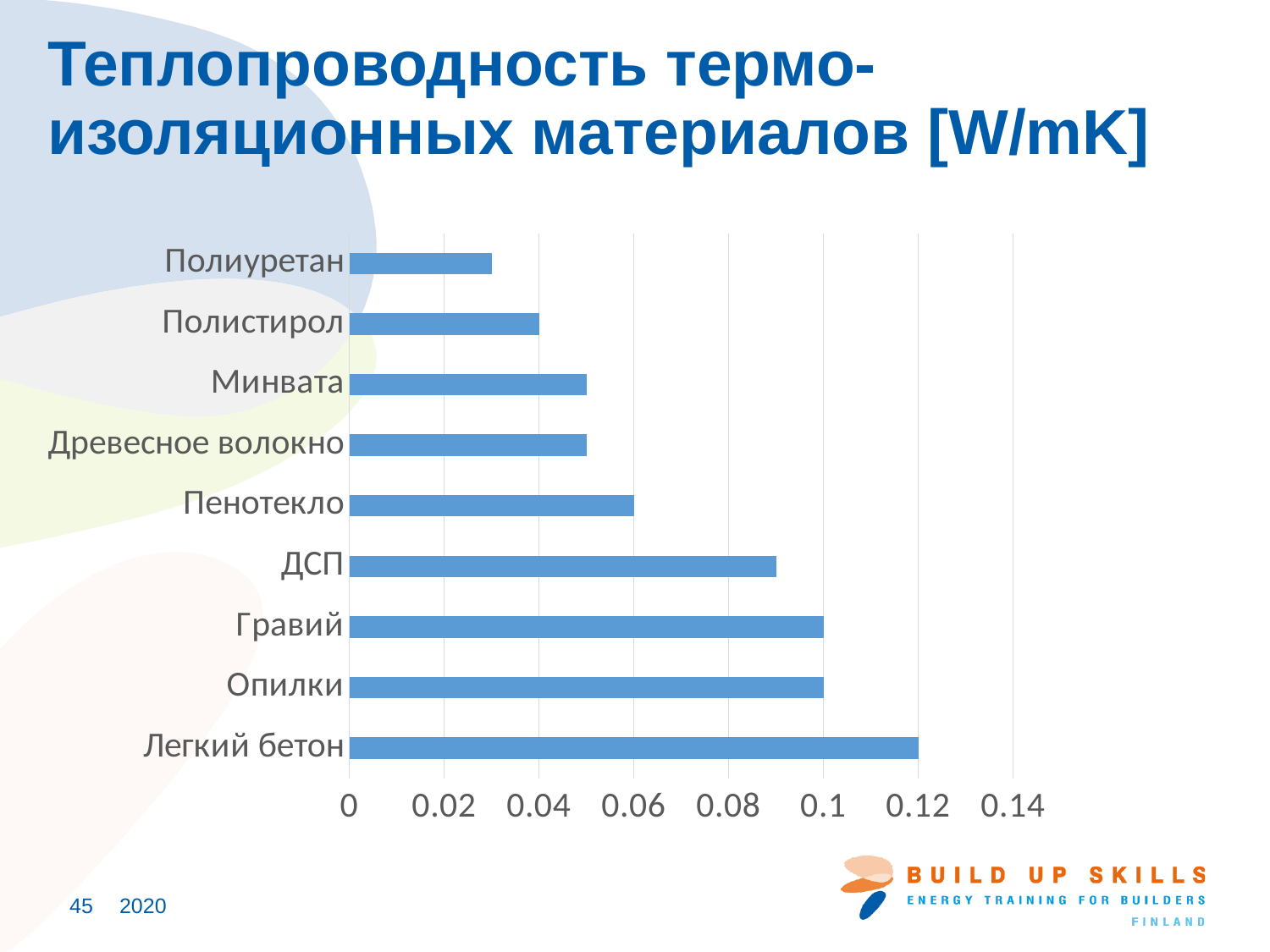
Which material has the lowest thermal conductivity in the chart? Полиуретан Is the value for ДСП greater or less than 0.08? greater What is the thermal conductivity value for Легкий бетон? 0.12 What is the thermal conductivity value for Гравий? 0.1 What kind of chart is shown on the slide? Bar chart How many materials (categories) are plotted in the chart? 9 What is the difference between the values for Легкий бетон and Опилки? 0.02 Which material has the highest thermal conductivity in the chart? Легкий бетон Is the value for Полиуретан greater or less than 0.04? less Which has a larger value, ДСП or Пенотекло? ДСП What is the thermal conductivity value for Пенотекло? 0.06 What is the thermal conductivity value for Полистирол? 0.04